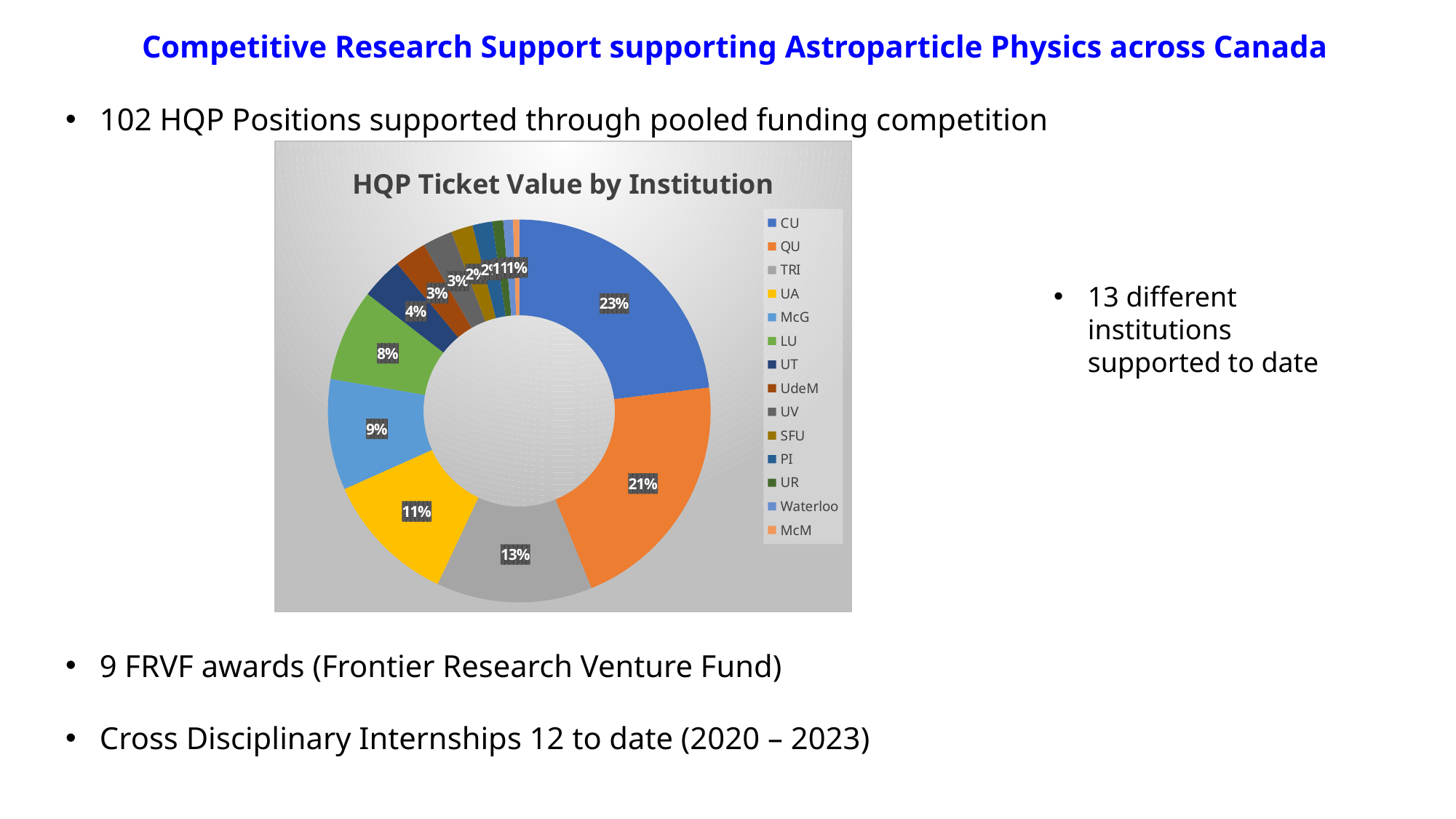
What share of HQP ticket value does QU have? 21% What share of HQP ticket value does TRI have? 13% What share of HQP ticket value does CU have? 23% What kind of chart is shown on the slide? Doughnut (pie) chart What is the difference in percentage points between CU's share and QU's share? 2% What share of HQP ticket value does McG have? 9% Which institution has the largest share of HQP ticket value? CU What share of HQP ticket value does LU have? 8% How many institutions are listed in the chart legend? 14 What is the title of the chart? HQP Ticket Value by Institution Which has the larger share, UA or McG? UA What share of HQP ticket value does UA have? 11%